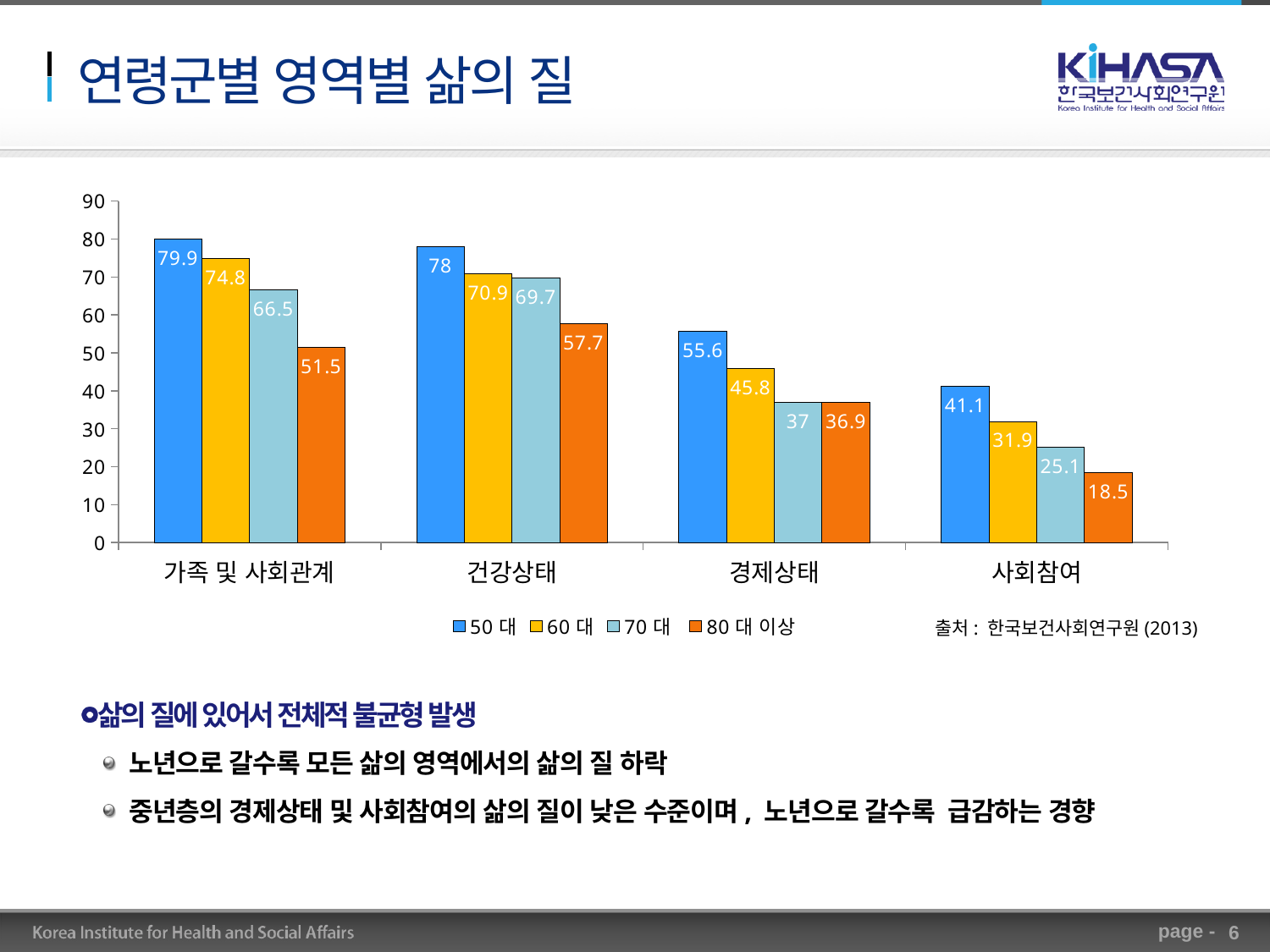
What is the difference between the 50대 and 80대 이상 values in the 건강상태 category? 20.3 Which is larger: the 60대 value for 건강상태 or the 60대 value for 가족 및 사회관계? 가족 및 사회관계 What is the value for 50대 in the 가족 및 사회관계 category? 79.9 How many categories are shown on the x axis? 4 How many series does the legend list? 4 What is the value for 70대 in the 경제상태 category? 37 Which category has the lowest value for 80대 이상? 사회참여 What is the value for 80대 이상 in the 사회참여 category? 18.5 What kind of chart is shown on the slide? bar chart Which category has the highest value for 50대? 가족 및 사회관계 Is the value for 70대 in the 사회참여 category greater or less than 30? less Within each category, do the values rise or fall as the age group increases from 50대 to 80대 이상? fall